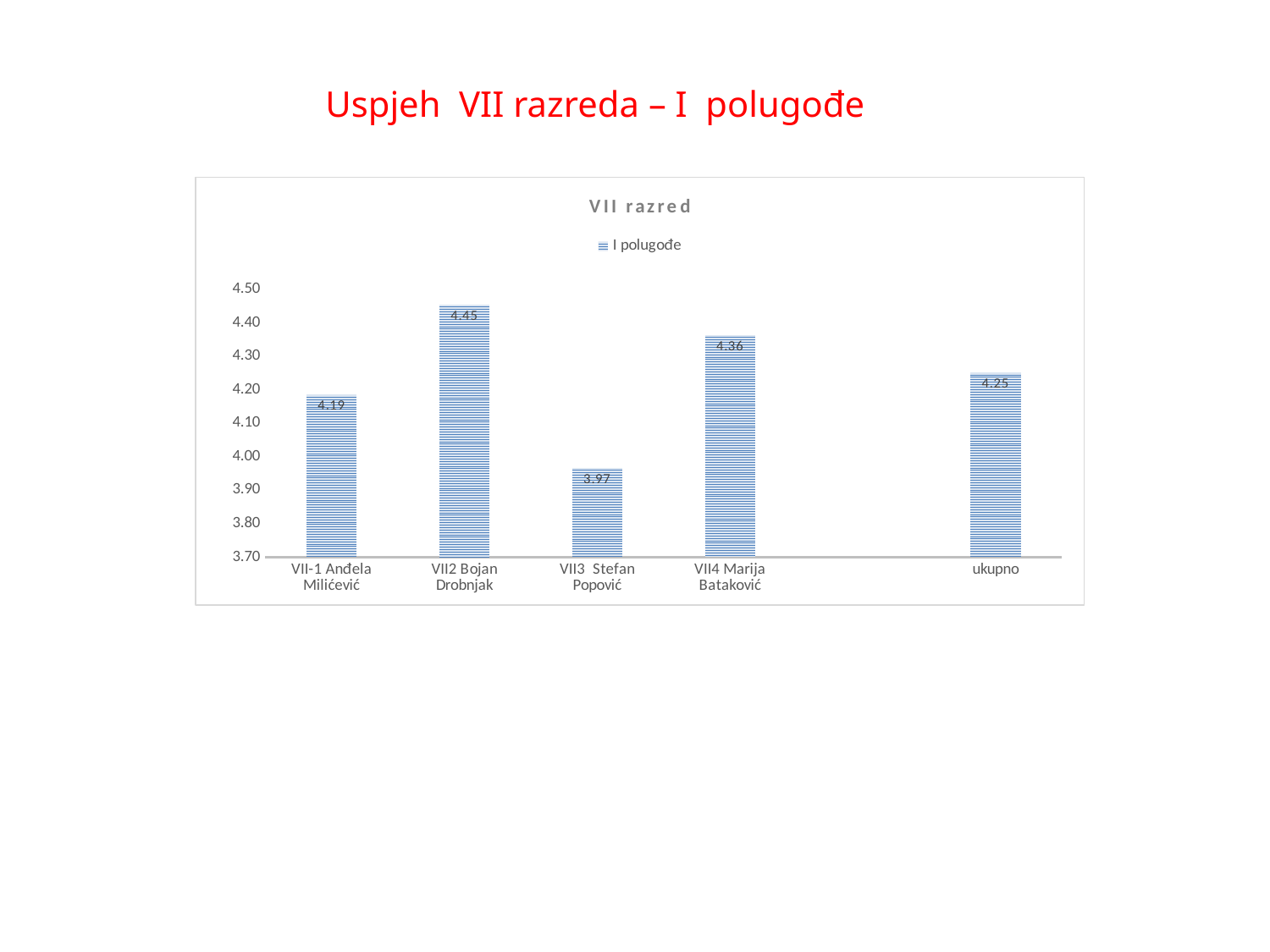
How many bars are shown in the chart? 5 What is the difference between the values for VII2 Bojan Drobnjak and VII3 Stefan Popović? 0.48 What is the value for VII2 Bojan Drobnjak? 4.45 What kind of chart is shown on the slide? bar chart What is the title of the chart? VII razred What is the value for ukupno? 4.25 Is the value for VII3 Stefan Popović greater or less than 4.00? less How many series does the legend list? 1 What is the value for VII3 Stefan Popović? 3.97 Which category has the lowest value? VII3 Stefan Popović Which category has the highest value? VII2 Bojan Drobnjak Which is larger, the value for VII4 Marija Bataković or the value for VII-1 Anđela Milićević? VII4 Marija Bataković